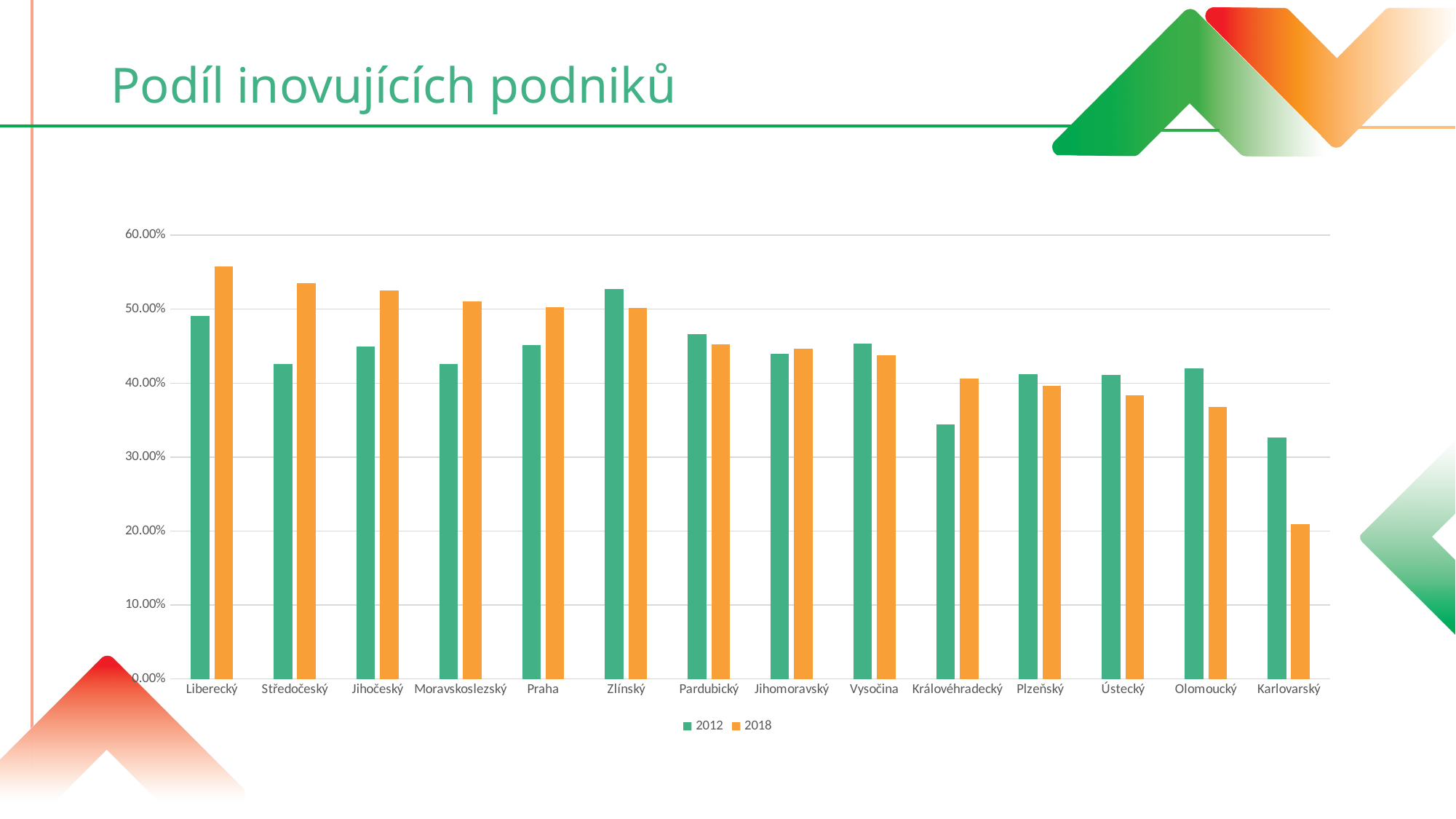
How many regions (categories) are shown on the x axis? 14 What kind of chart is shown on the slide? bar chart For Olomoucký, which series has the larger value, 2012 or 2018? 2012 Do the 2018 values generally rise or fall from left to right along the x axis? fall For Středočeský, which series has the larger value, 2012 or 2018? 2018 Which region has the lowest value for 2018? Karlovarský Which region has the highest value for 2012? Zlínský Which region has the lowest value for 2012? Karlovarský Which region has the highest value for 2018? Liberecký Is the 2018 value for Karlovarský greater or less than 30.00%? less How many series does the legend list? 2 Is the 2018 value for Liberecký greater or less than 50.00%? greater